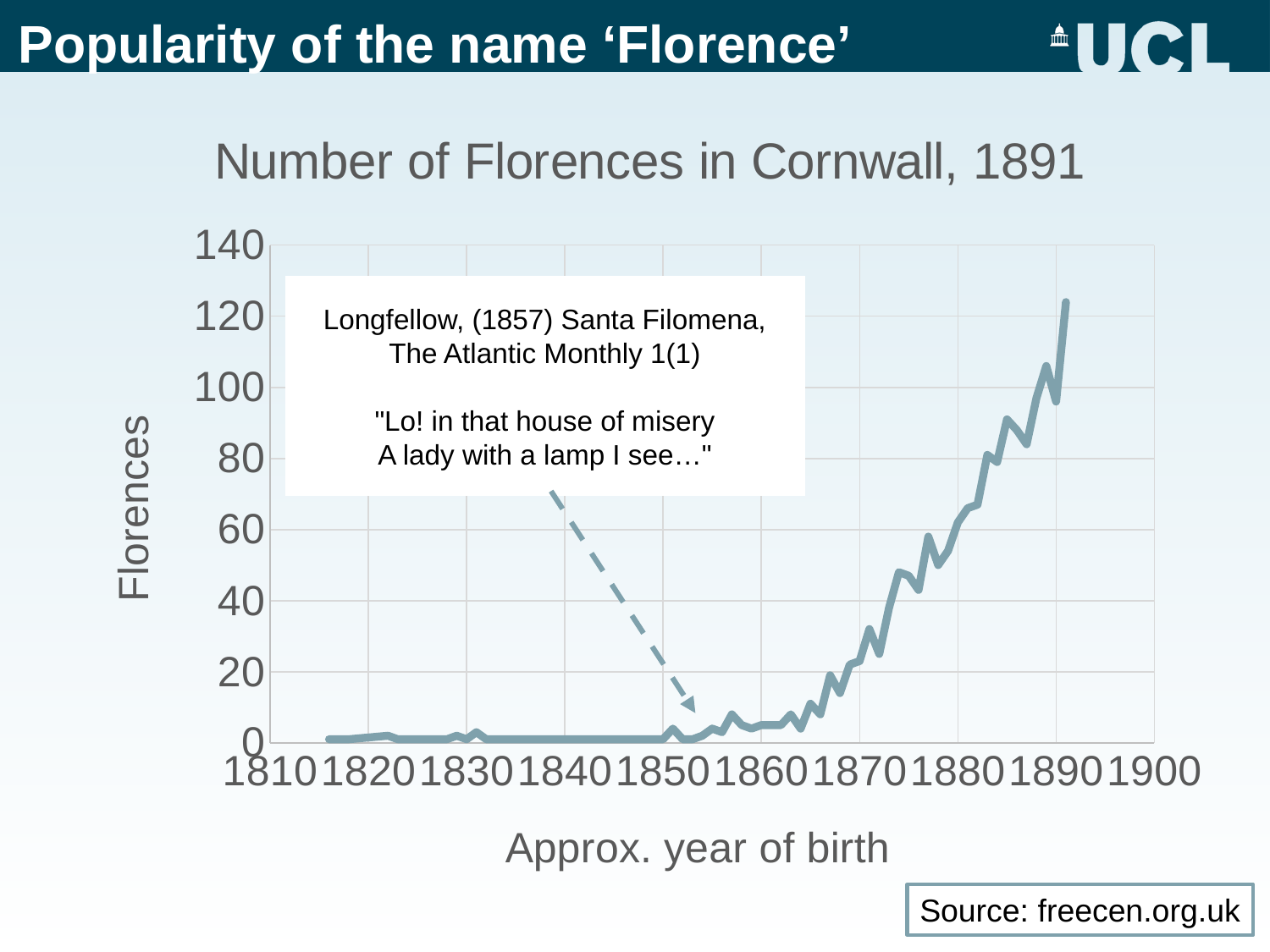
Is the value for a birth year of 1870 greater or less than 40? less Does the line reach its highest value at the left end or the right end of the x axis? right end Is the highest value on the line greater or less than 100? greater Is the value for a birth year of 1880 greater or less than 40? greater Which is larger, the value for a birth year of 1880 or the value for a birth year of 1860? 1880 Overall, do the values rise or fall as the year of birth increases from 1810 to 1890? rise What is the label on the vertical axis of the chart? Florences What is the title of the chart? Number of Florences in Cornwall, 1891 What kind of chart is shown on the slide? line chart